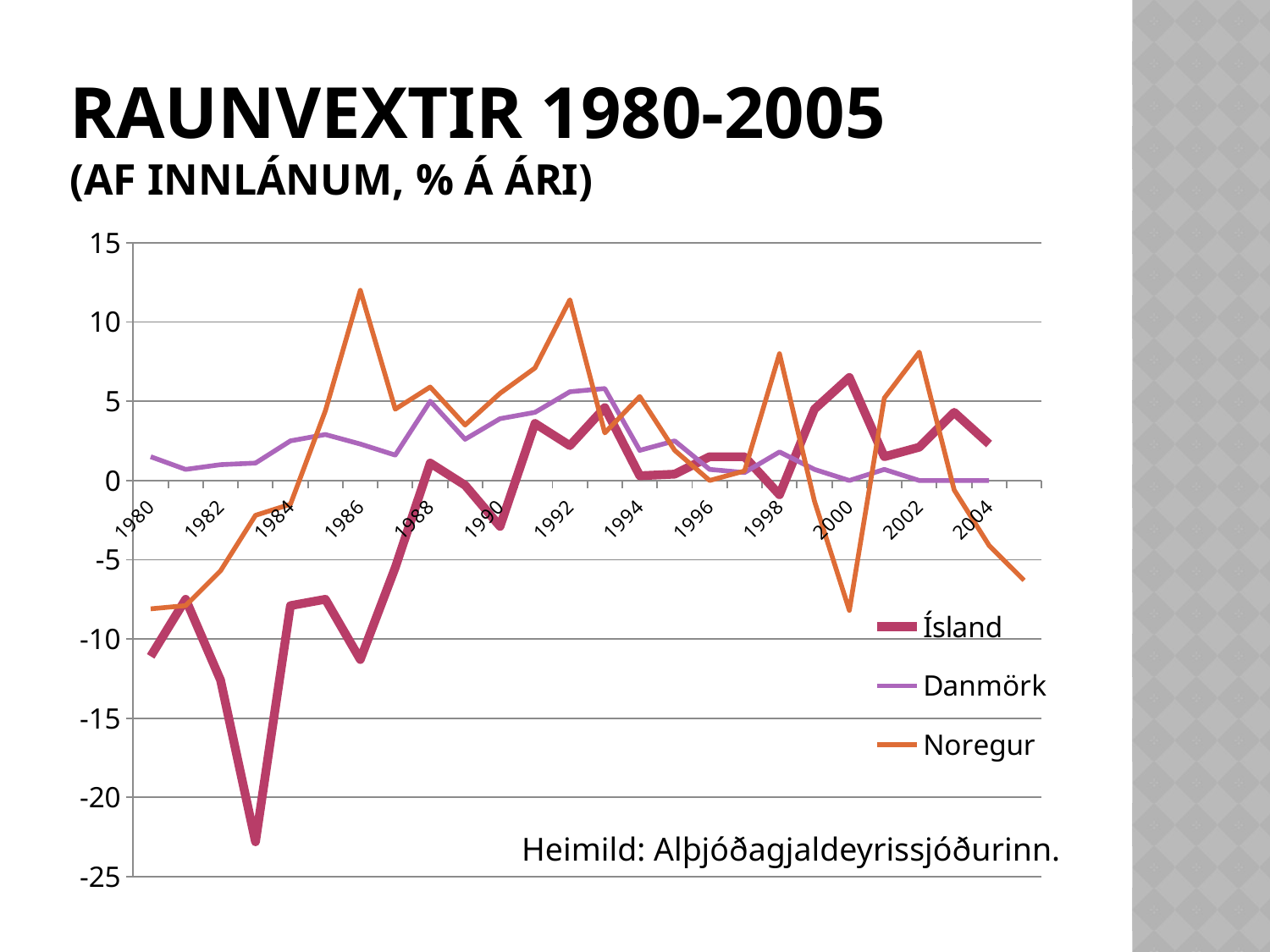
Which series reaches the lowest value on the chart? Ísland Is the value for Noregur in 1986 greater or less than 10? greater Which three countries are listed in the legend? Ísland, Danmörk, Noregur What kind of chart is shown on the slide? line chart In 1983, which series has the larger value, Ísland or Noregur? Noregur How many series does the legend list? 3 In which year does the Ísland series reach its lowest value? 1983 What is the title of the chart? Raunvextir 1980-2005 (af innlánum, % á ári) Does the Ísland series rise or fall between 1983 and 1988? rise Is the value for Ísland in 1983 greater or less than -20? less In which year does the Noregur series reach its highest value? 1986 Is the value for Noregur in 2000 greater or less than -5? less